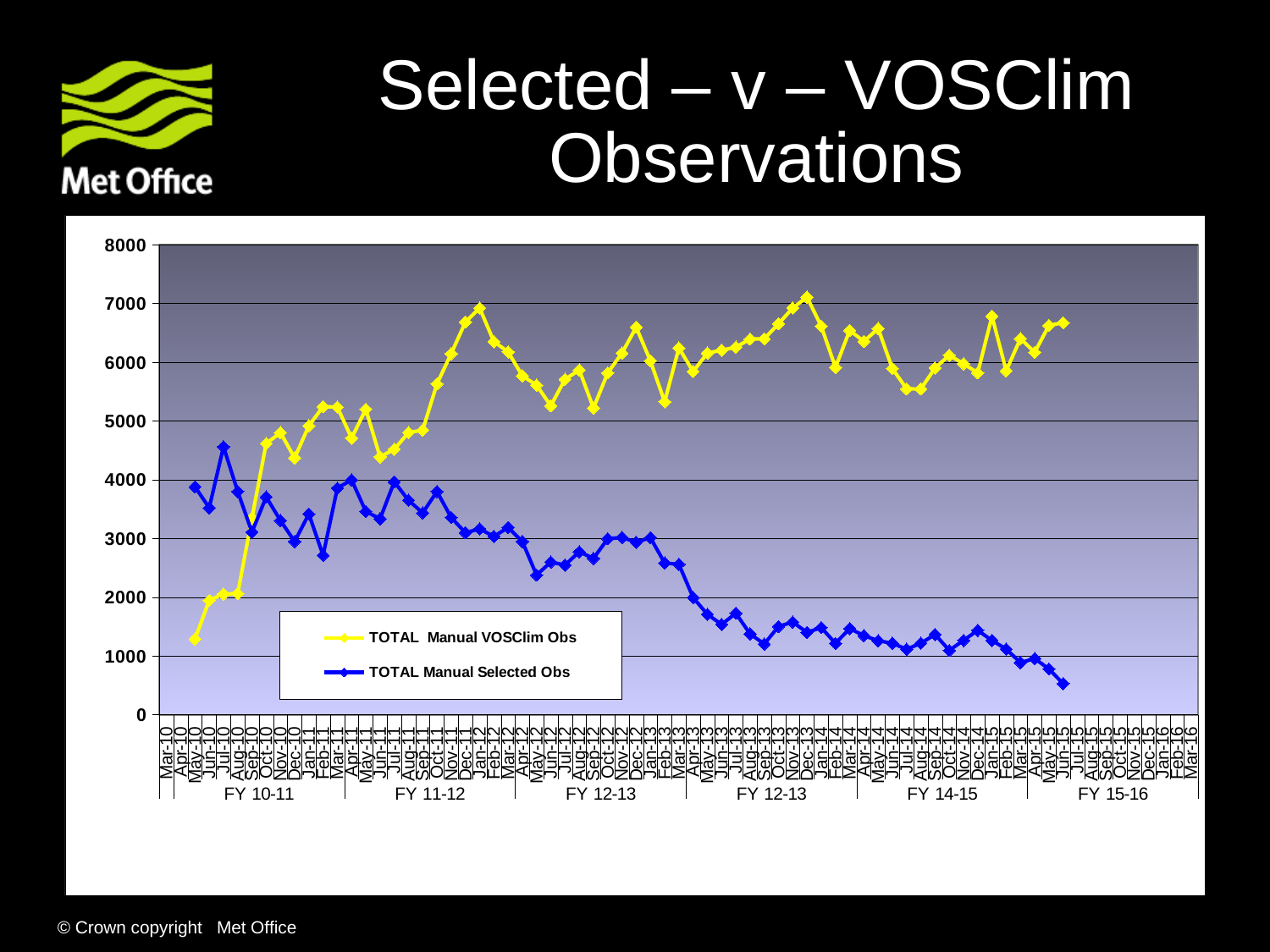
Is the value for TOTAL Manual Selected Obs in Jun-15 greater or less than 1000? less In Jan-12, which series has the higher value, TOTAL Manual VOSClim Obs or TOTAL Manual Selected Obs? TOTAL Manual VOSClim Obs What are the two series named in the legend? TOTAL Manual VOSClim Obs and TOTAL Manual Selected Obs What kind of chart is shown on the slide? Line chart How many series does the chart's legend list? 2 What colour is the line for TOTAL Manual VOSClim Obs? Yellow Is the value for TOTAL Manual VOSClim Obs in Jan-12 greater or less than 6000? greater Does the TOTAL Manual Selected Obs series generally rise or fall from Mar-10 to Jun-15? Fall In Jun-10, which series has the higher value, TOTAL Manual VOSClim Obs or TOTAL Manual Selected Obs? TOTAL Manual Selected Obs Is the value for TOTAL Manual VOSClim Obs in May-10 greater or less than 2000? less In which month does the TOTAL Manual Selected Obs series reach its lowest value? Jun-15